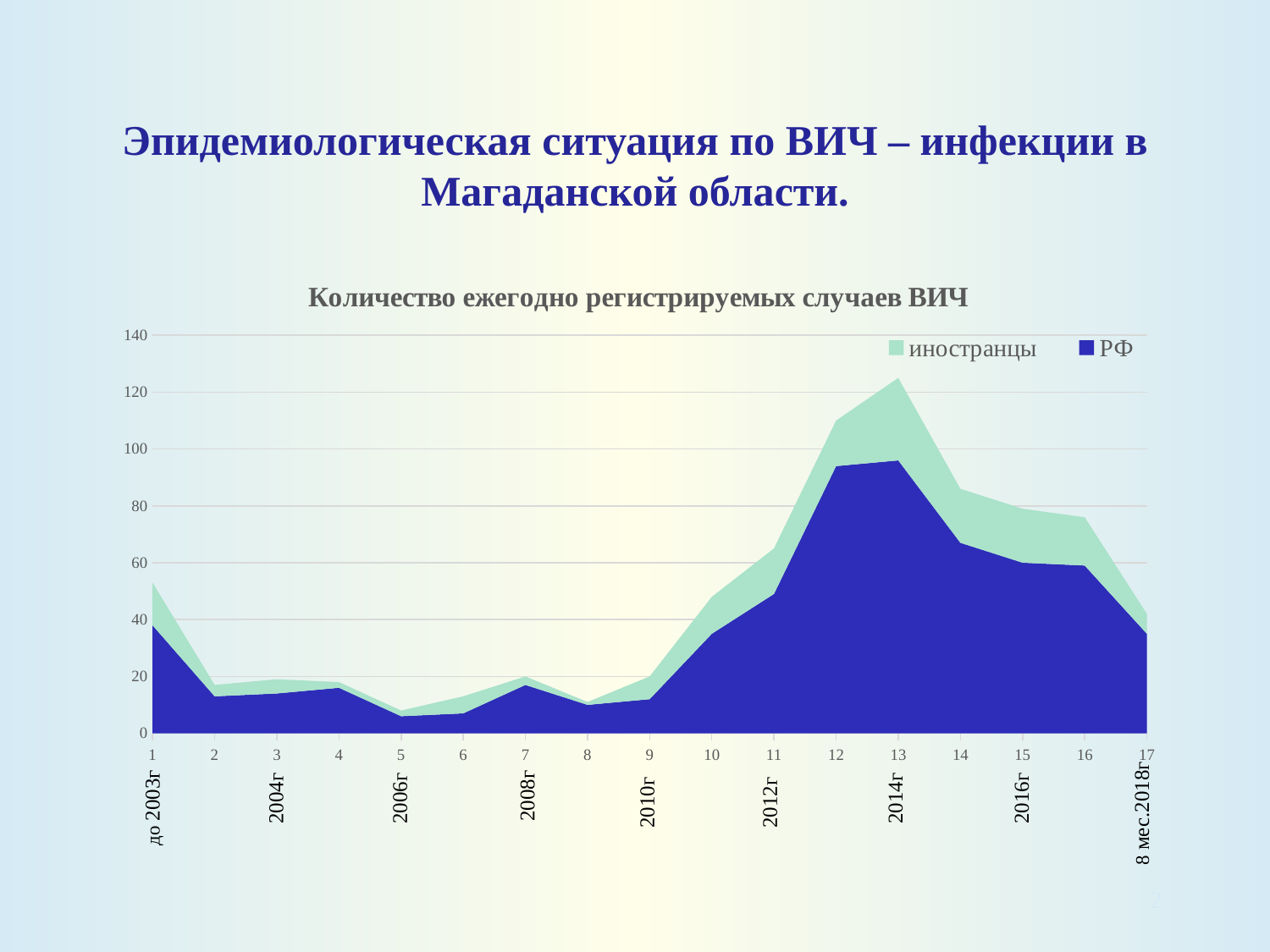
Which is larger, the РФ value in 2012г or the РФ value in 2010г? 2012г What is the title of the chart? Количество ежегодно регистрируемых случаев ВИЧ What are the two series named in the legend? иностранцы and РФ Does the РФ series rise or fall from 2014г to 8 мес.2018г? fall What kind of chart is shown on the slide? area chart How many data points are plotted along the x axis? 17 How many series does the legend list? 2 Is the combined total of both series in 2014г greater or less than 100? greater Is the value for РФ in 2014г greater or less than 80? greater In which year does the РФ series reach its highest value? 2014г In which year is the combined total of both series lowest? 2006г Is the value for РФ in 2006г greater or less than 20? less